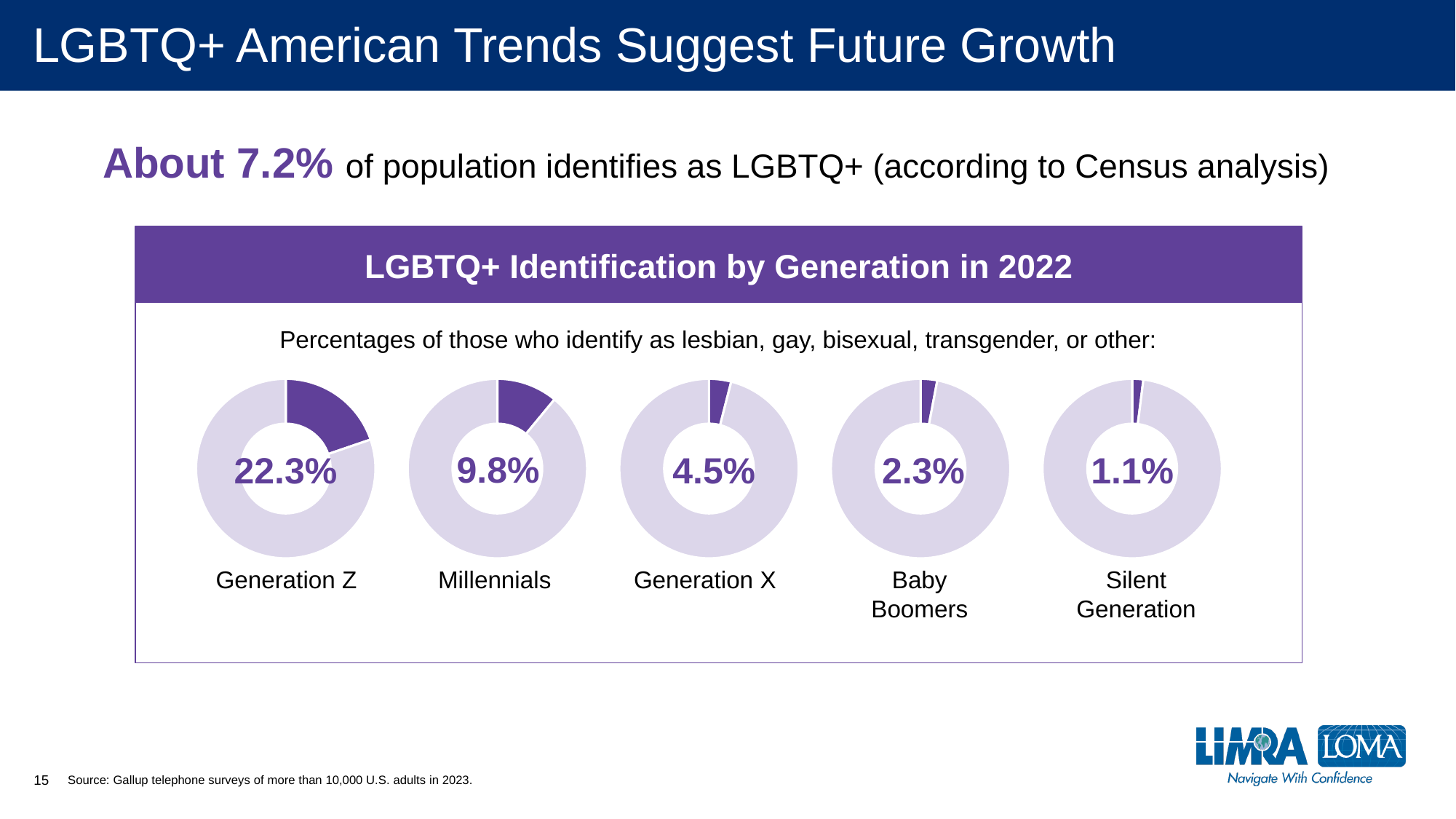
In the 'LGBTQ+ Identification by Generation in 2022' chart, what is the value shown for Millennials? 9.8% In the 'LGBTQ+ Identification by Generation in 2022' chart, what percentage of Generation Z identifies as LGBTQ+? 22.3% In the 'LGBTQ+ Identification by Generation in 2022' chart, what is the value shown for Baby Boomers? 2.3% How many generations are shown in the 'LGBTQ+ Identification by Generation in 2022' chart? 5 What kind of chart is used to show each generation's value in the 'LGBTQ+ Identification by Generation in 2022' chart? Donut chart In the 'LGBTQ+ Identification by Generation in 2022' chart, which generation has the highest percentage identifying as LGBTQ+? Generation Z In the 'LGBTQ+ Identification by Generation in 2022' chart, which has a higher value, Generation X or Baby Boomers? Generation X In the 'LGBTQ+ Identification by Generation in 2022' chart, what is the difference in percentage points between Generation X and Baby Boomers? 2.2 In the 'LGBTQ+ Identification by Generation in 2022' chart, which generation has the lowest percentage identifying as LGBTQ+? Silent Generation In the 'LGBTQ+ Identification by Generation in 2022' chart, do the values rise or fall moving from Generation Z on the left to the Silent Generation on the right? Fall In the 'LGBTQ+ Identification by Generation in 2022' chart, what is the difference in percentage points between Generation Z and Millennials? 12.5 In the 'LGBTQ+ Identification by Generation in 2022' chart, what is the value shown for the Silent Generation? 1.1%